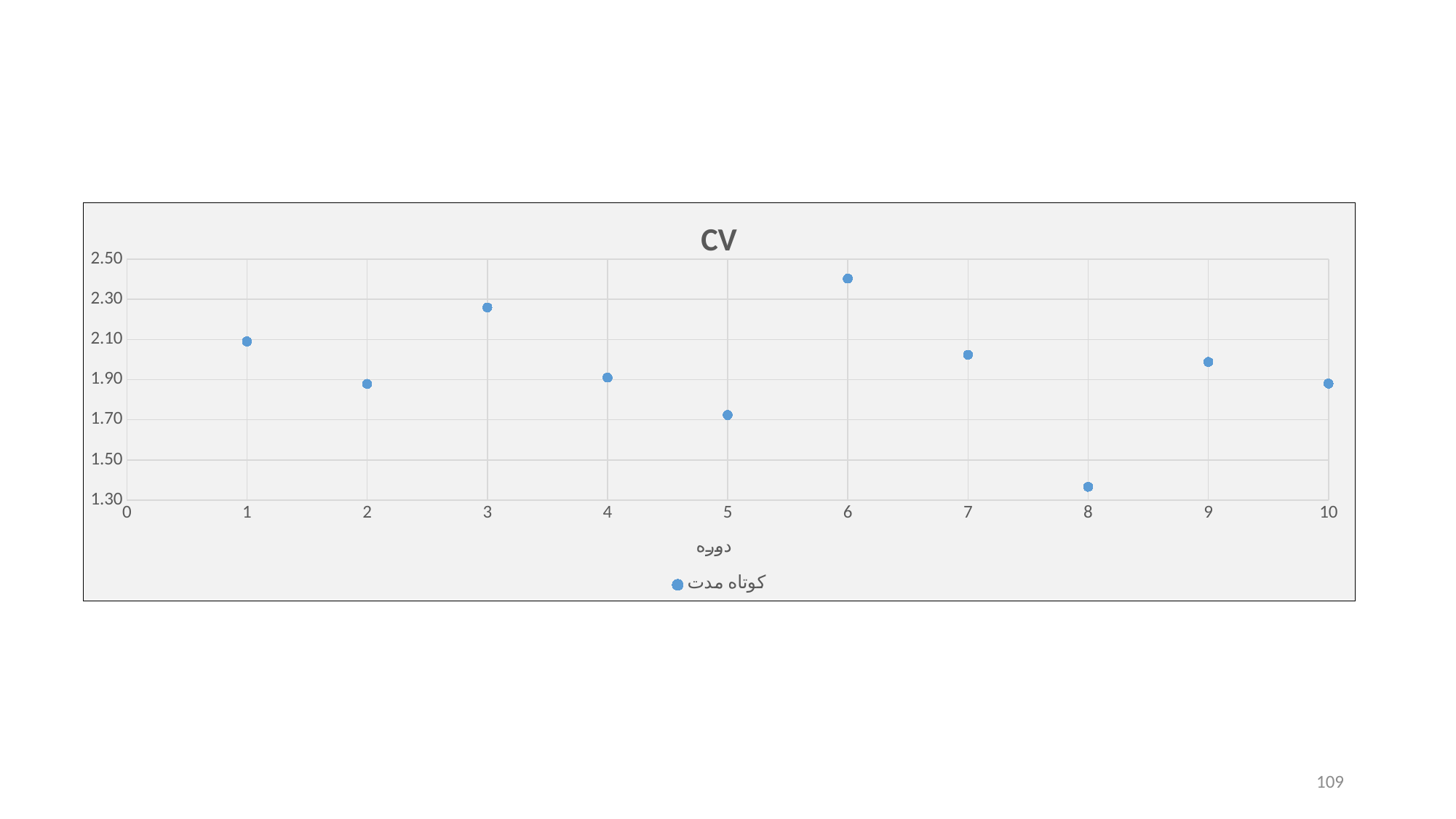
Which has the larger value, period 7 or period 5? period 7 Is the value at period 5 greater or less than 1.90? less Is the value at period 8 greater or less than 1.50? less How many series does the legend list? 1 What kind of chart is shown on the slide? scatter chart How many data points are plotted in the chart? 10 Is the value at period 3 greater or less than 2.10? greater At which x value (period) is the plotted CV value highest? 6 Which has the larger value, period 1 or period 2? period 1 At which x value (period) is the plotted CV value lowest? 8 What is the title of the chart? CV